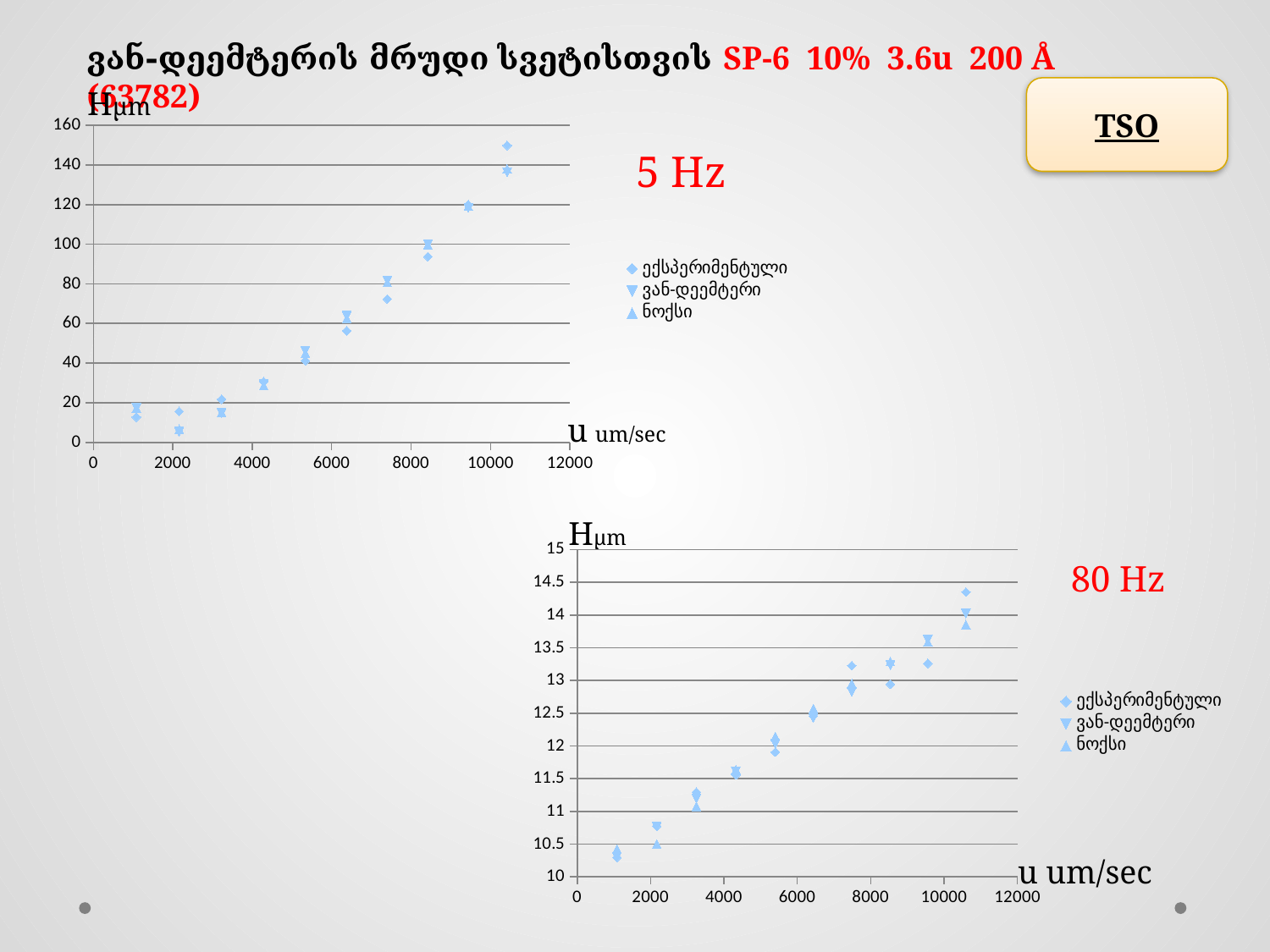
How many series does the legend of the 5 Hz chart list? 3 In the 80 Hz chart, is the highest ექსპერიმენტული value (at the rightmost point) greater or less than 14? greater In the 5 Hz chart, at the rightmost point, which series has the larger value: ექსპერიმენტული or ვან-დეემტერი? ექსპერიმენტული What is the label on the y axis of the 80 Hz chart? Hμm In the 80 Hz chart, do the values rise or fall as u increases along the x axis? rise In the 5 Hz chart, do the values rise or fall as u increases along the x axis? rise What is the label on the x axis of the 5 Hz chart? u um/sec How many series does the legend of the 80 Hz chart list? 3 In the 80 Hz chart, is the leftmost ექსპერიმენტული value (near u = 1000) greater or less than 10.5? less What kind of chart is the 5 Hz chart? scatter chart What kind of chart is the 80 Hz chart? scatter chart In the 5 Hz chart, is the highest ექსპერიმენტული value (at the rightmost point) greater or less than 140? greater